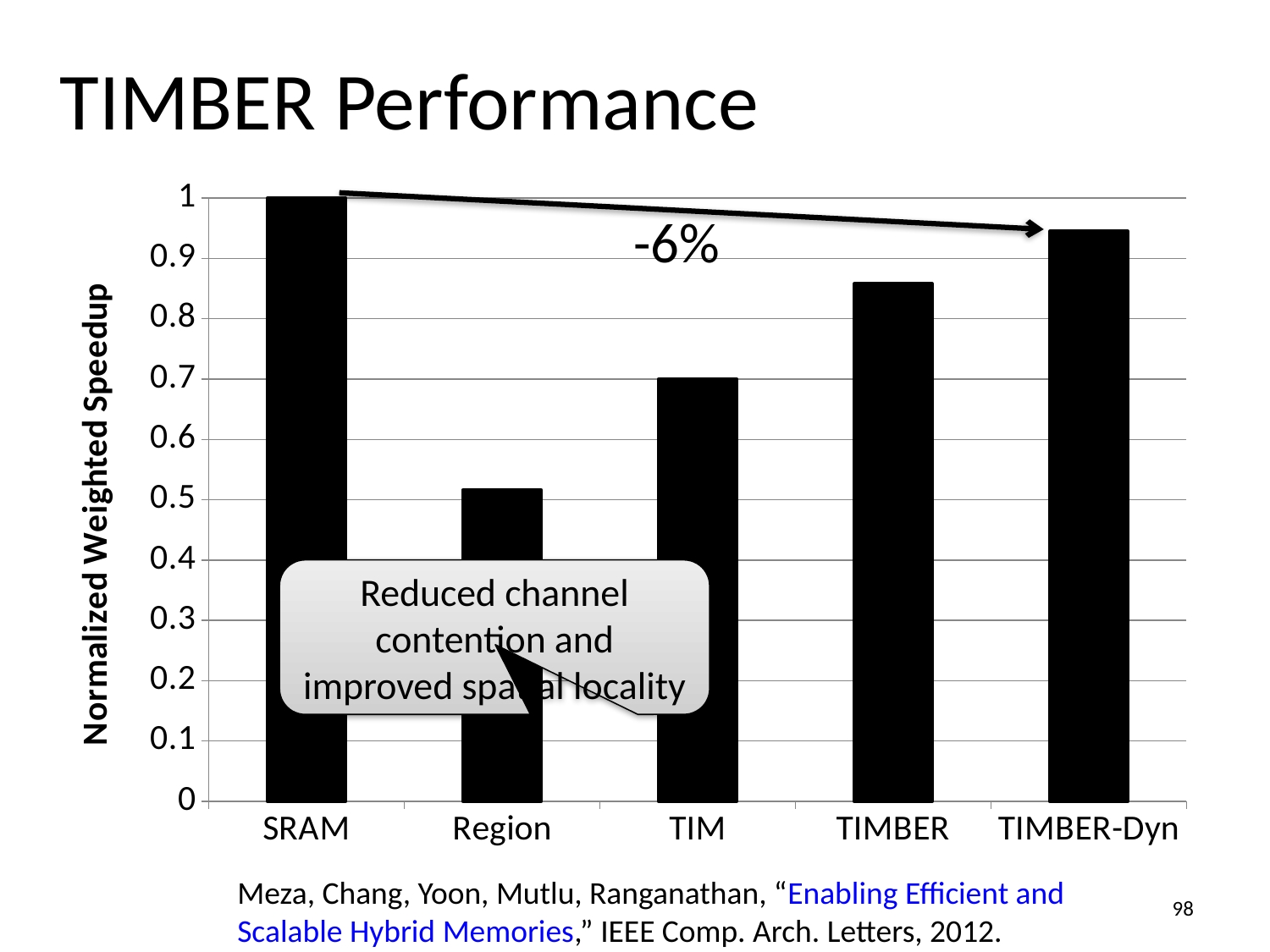
How many categories are shown on the x axis of the chart? 5 What is the normalized weighted speedup for SRAM? 1 What kind of chart is shown on the slide? bar chart What percentage change is annotated by the arrow from SRAM to TIMBER-Dyn? -6% Is the value for TIMBER greater or less than 0.8? greater Is the value for Region greater or less than 0.6? less What is the label on the y axis of the chart? Normalized Weighted Speedup Which category has the highest normalized weighted speedup? SRAM Which category has the lowest normalized weighted speedup? Region Which has a higher normalized weighted speedup, TIM or Region? TIM Is the value for TIMBER-Dyn greater or less than 0.9? greater Which has a higher normalized weighted speedup, TIMBER or TIMBER-Dyn? TIMBER-Dyn